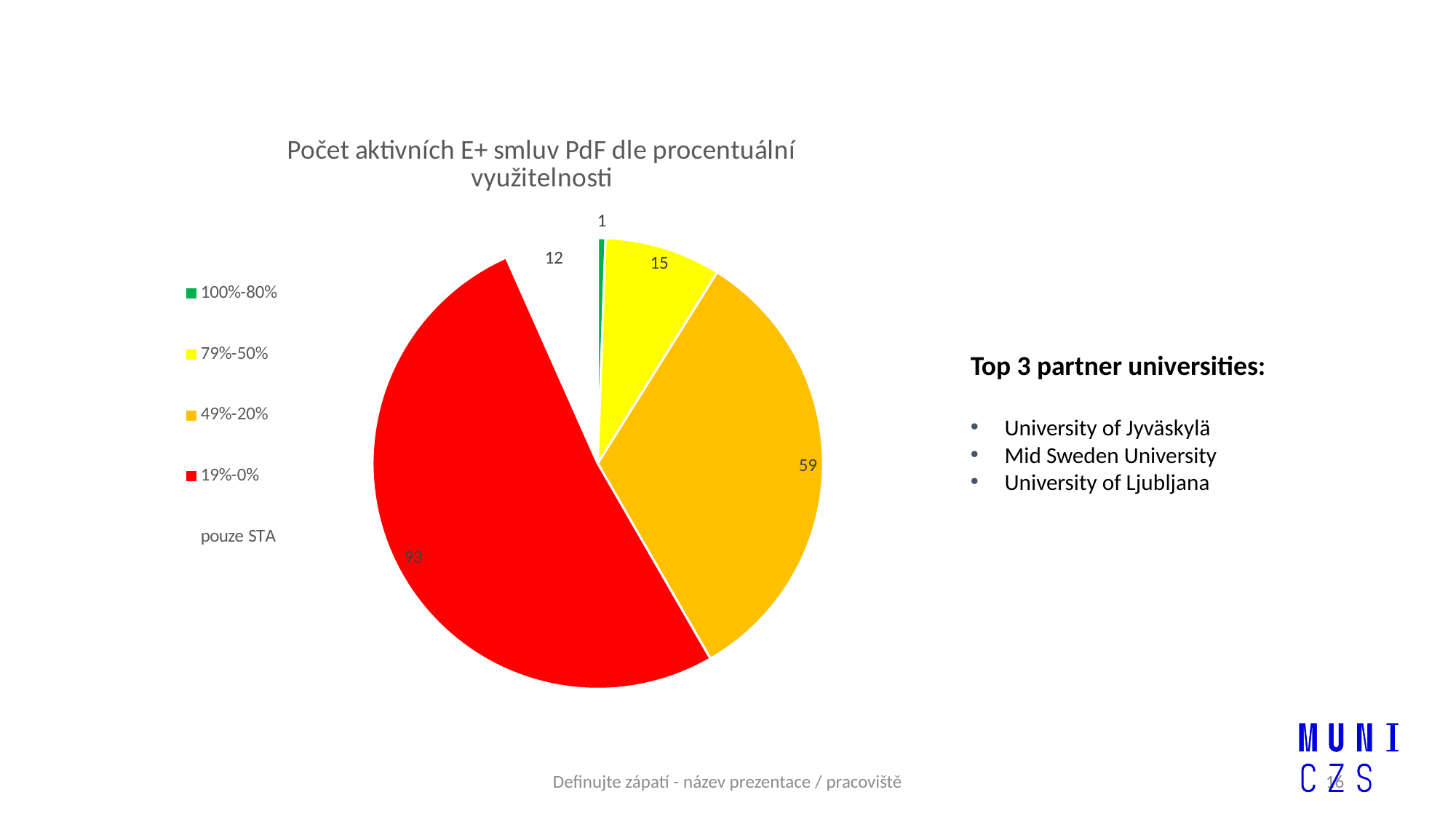
Which category has the largest slice of the pie? 19%-0% What is the value for the pouze STA category? 12 What is the value for the 49%-20% category? 59 Which is larger, the 79%-50% value or the pouze STA value? 79%-50% How many categories does the legend list? 5 Which category has the smallest slice of the pie? 100%-80% What is the value for the 79%-50% category? 15 What is the value for the 19%-0% category? 93 What is the difference between the 19%-0% value and the 49%-20% value? 34 What type of chart is shown on the slide? pie chart What is the value for the 100%-80% category? 1 What is the title of the chart? Počet aktivních E+ smluv PdF dle procentuální využitelnosti